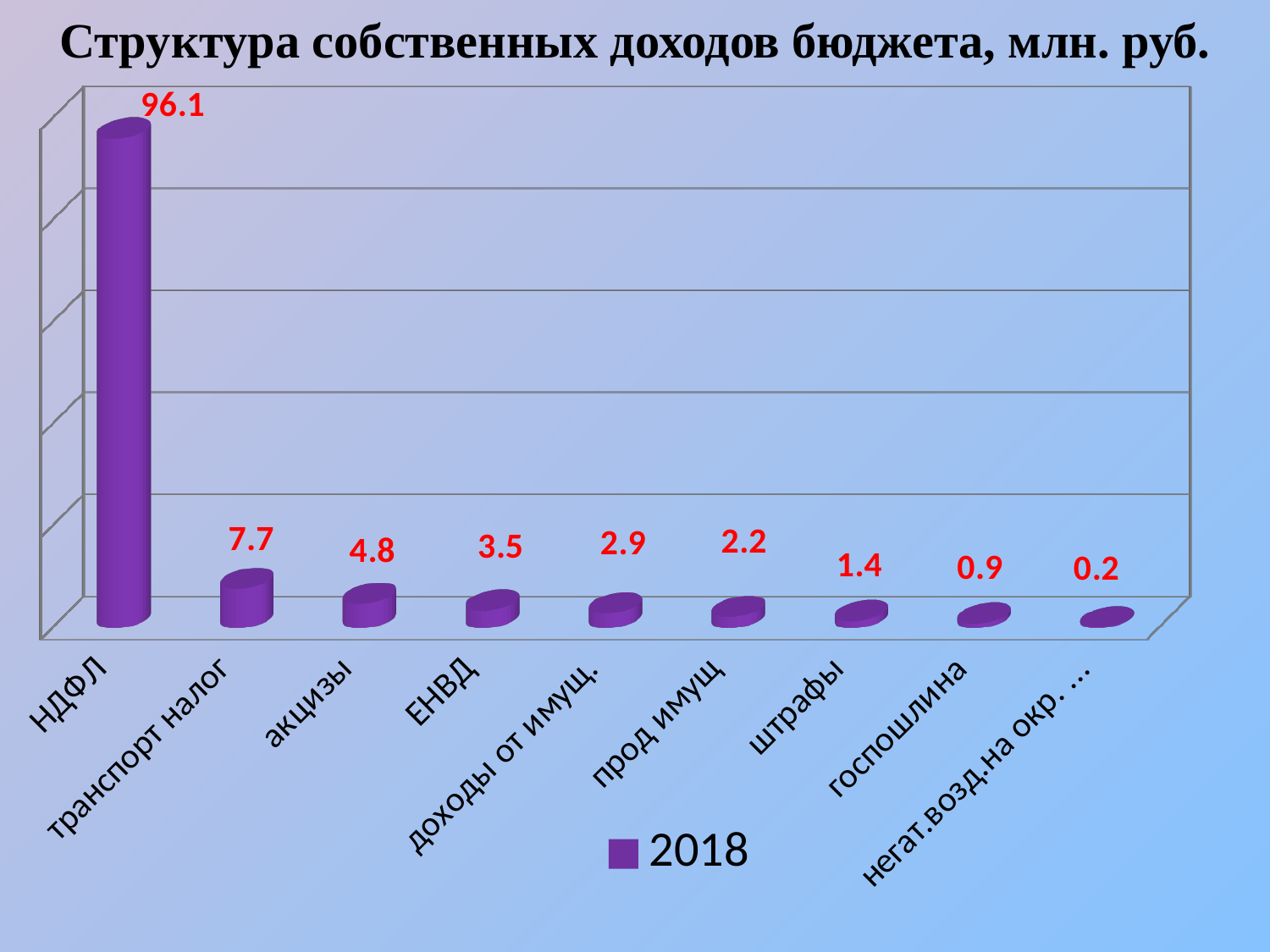
What is the difference between the values for акцизы and штрафы? 3.4 What is the value for транспорт налог? 7.7 Which category has the highest value? НДФЛ What is the difference between the values for НДФЛ and транспорт налог? 88.4 What is the value for НДФЛ? 96.1 What kind of chart is this? bar chart What is the value for госпошлина? 0.9 Which year does the legend show? 2018 What is the value for ЕНВД? 3.5 Which is larger, the value for доходы от имущ. or the value for прод имущ? доходы от имущ. Which category has the lowest value? негат.возд.на окр. ... How many categories are shown on the x axis? 9